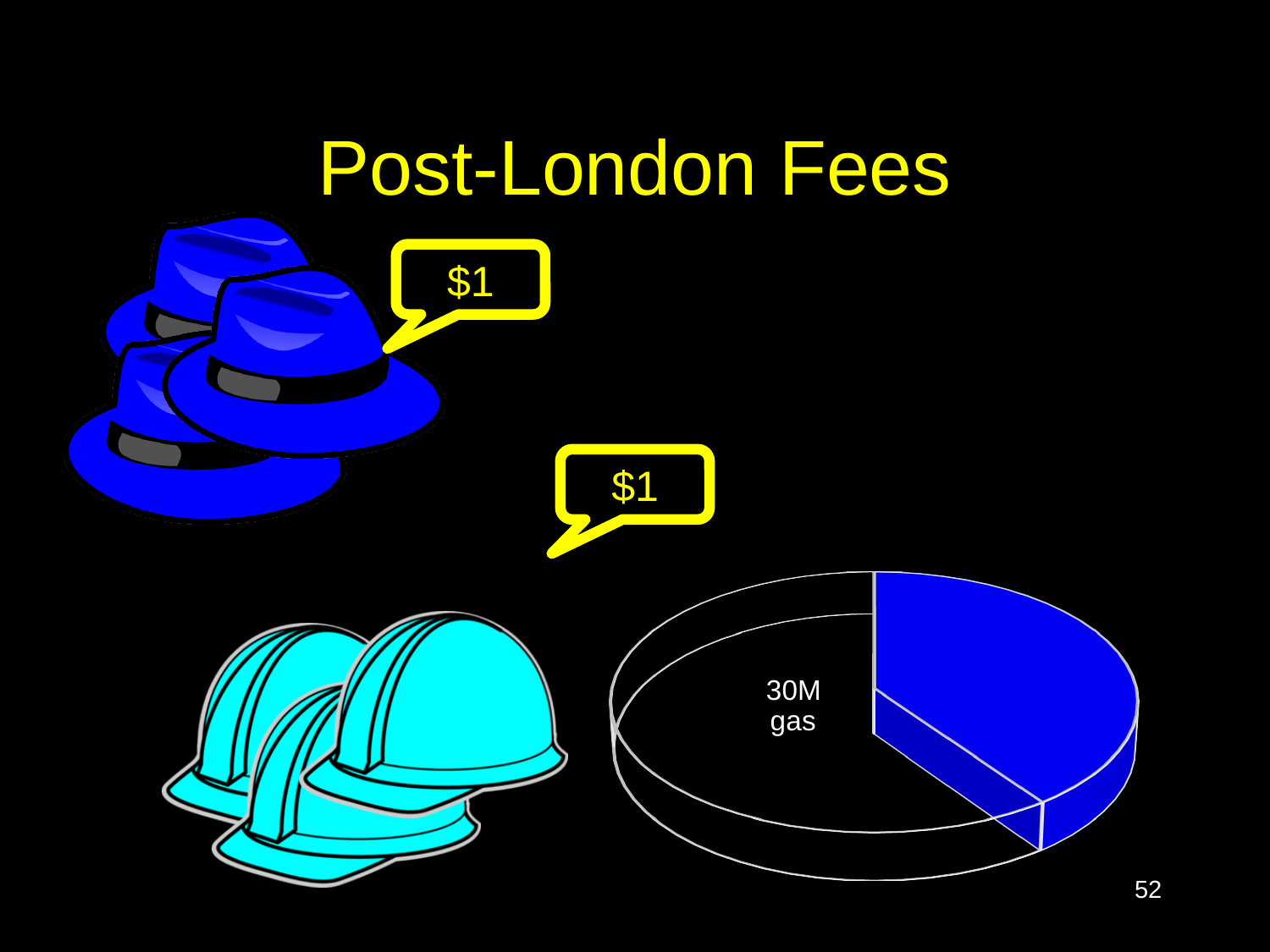
What colour is the filled slice of the pie chart? blue What label is printed inside the pie chart? 30M gas Is the blue slice of the pie chart more or less than half of the pie? less What is the title of the slide containing the pie chart? Post-London Fees What kind of chart is shown on the slide? pie chart Which is larger in the pie chart: the blue filled slice or the unfilled remainder? the unfilled remainder